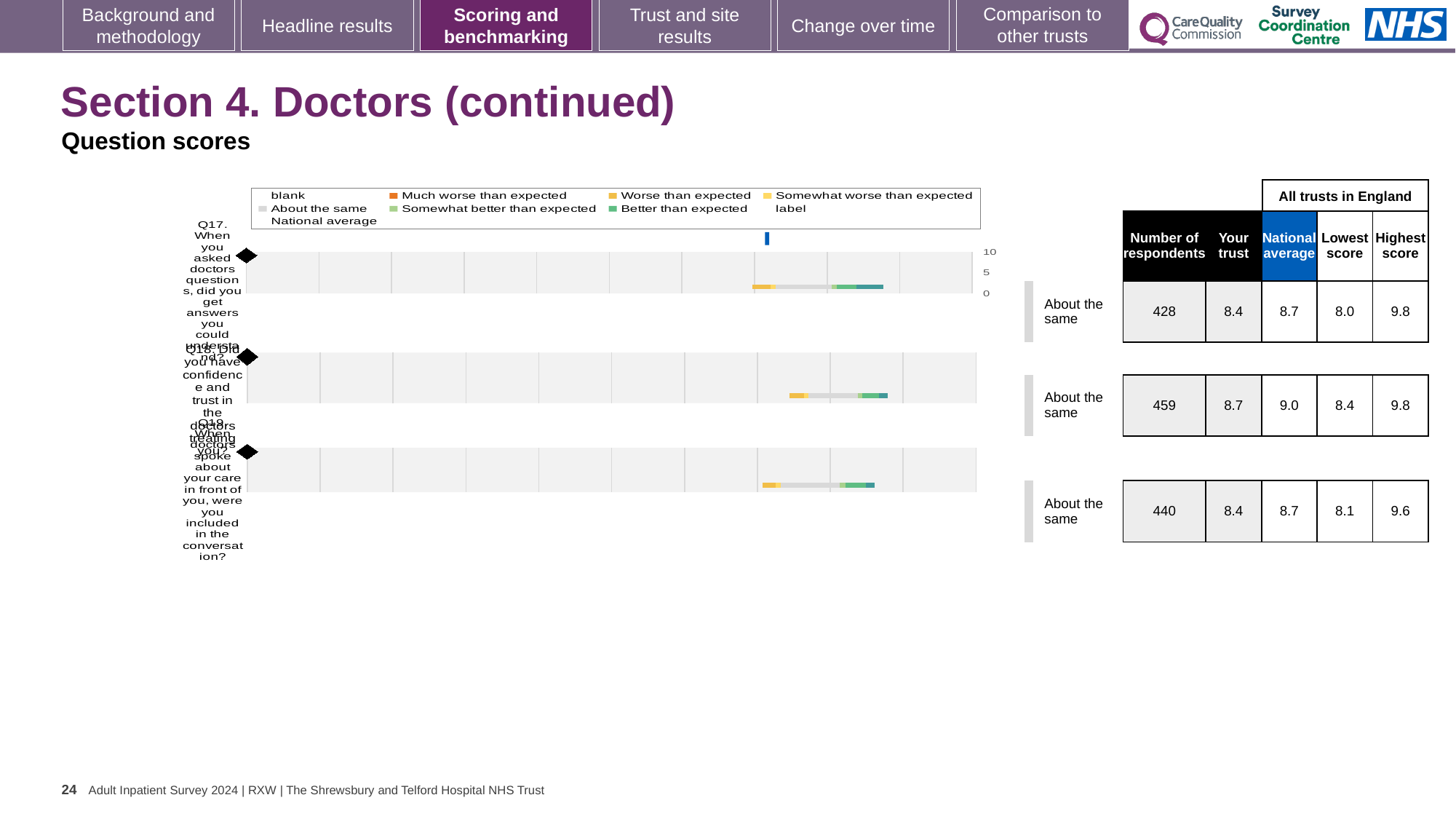
What colour does the legend use for 'Much worse than expected'? orange What benchmark category is shown next to the chart for Q17? About the same According to the table beside the chart, what is the lowest score for Q18? 8.4 According to the table beside the chart, what is the 'Your trust' score for Q17? 8.4 Which of the three questions has the lowest 'Lowest score' value in the table? Q17 What kind of chart is used to show the question scores on this slide? bar chart Which is larger, the highest score for Q17 or the highest score for Q19? Q17 What is the difference between the national average and the 'Your trust' score for Q18? 0.3 Which of the three questions has the highest 'Your trust' score in the table? Q18 How many questions (categories) are plotted in the chart area on this slide? 3 According to the table beside the chart, how many respondents answered Q19? 440 According to the table beside the chart, what is the national average for Q18? 9.0